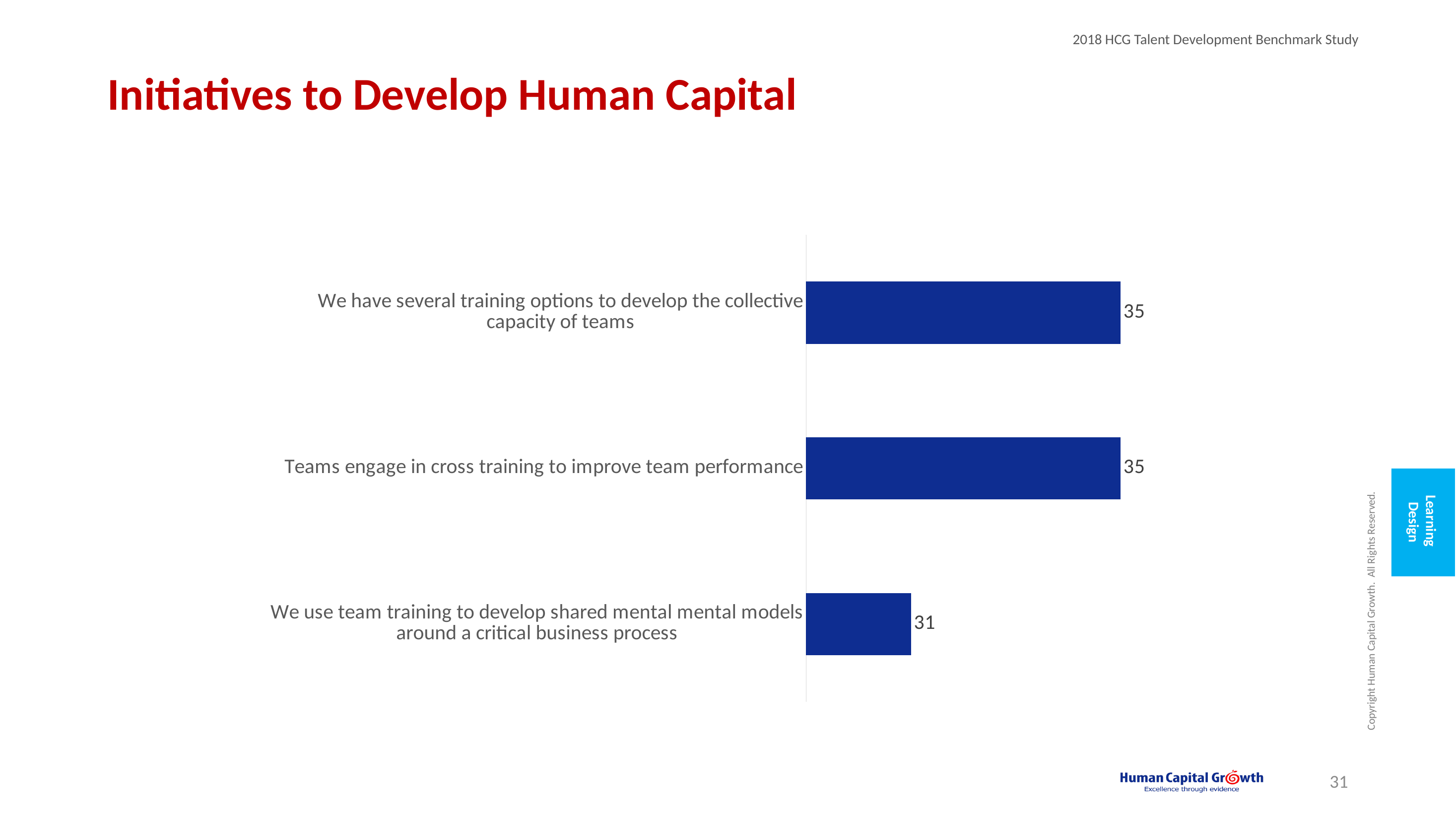
What colour are the bars in the chart? Dark blue Which category has the lowest value? We use team training to develop shared mental mental models around a critical business process Do the two top categories, "We have several training options to develop the collective capacity of teams" and "Teams engage in cross training to improve team performance", have the same value? Yes What is the difference between the value for "Teams engage in cross training to improve team performance" and the value for "We use team training to develop shared mental mental models around a critical business process"? 4 What is the title of the slide containing the chart? Initiatives to Develop Human Capital What is the value for "We use team training to develop shared mental mental models around a critical business process"? 31 What is the value for "Teams engage in cross training to improve team performance"? 35 What is the value for "We have several training options to develop the collective capacity of teams"? 35 How many categories are shown in the chart? 3 Which is larger: the value for "We have several training options to develop the collective capacity of teams" or the value for "We use team training to develop shared mental mental models around a critical business process"? We have several training options to develop the collective capacity of teams What kind of chart is shown on the slide? Bar chart